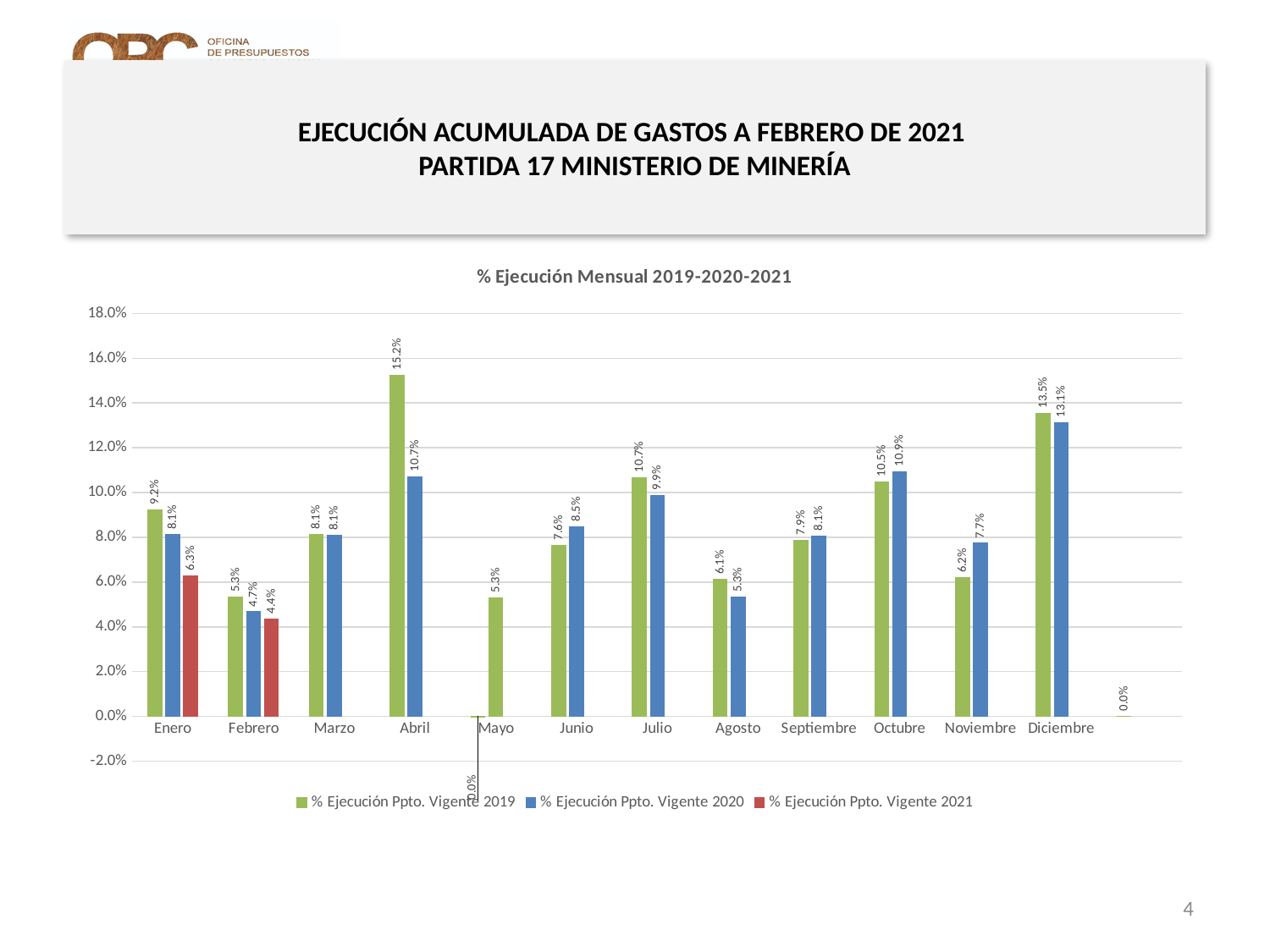
What is the title of the chart? % Ejecución Mensual 2019-2020-2021 Which month has the highest value in the % Ejecución Ppto. Vigente 2019 series? Abril What is the value for Abril in the % Ejecución Ppto. Vigente 2019 series? 15.2% For Octubre, which series has the larger value, 2019 or 2020? 2020 What is the difference between the 2019 and 2020 values for Diciembre? 0.4% Is the value for Abril in the 2020 series greater or less than 10.0%? greater How many series does the legend list? 3 What is the value for Diciembre in the % Ejecución Ppto. Vigente 2020 series? 13.1% What kind of chart is shown on the slide? bar chart What is the value for Enero in the % Ejecución Ppto. Vigente 2021 series? 6.3% What is the value for Febrero in the % Ejecución Ppto. Vigente 2021 series? 4.4% What is the difference between the 2019 and 2020 values for Enero? 1.1%